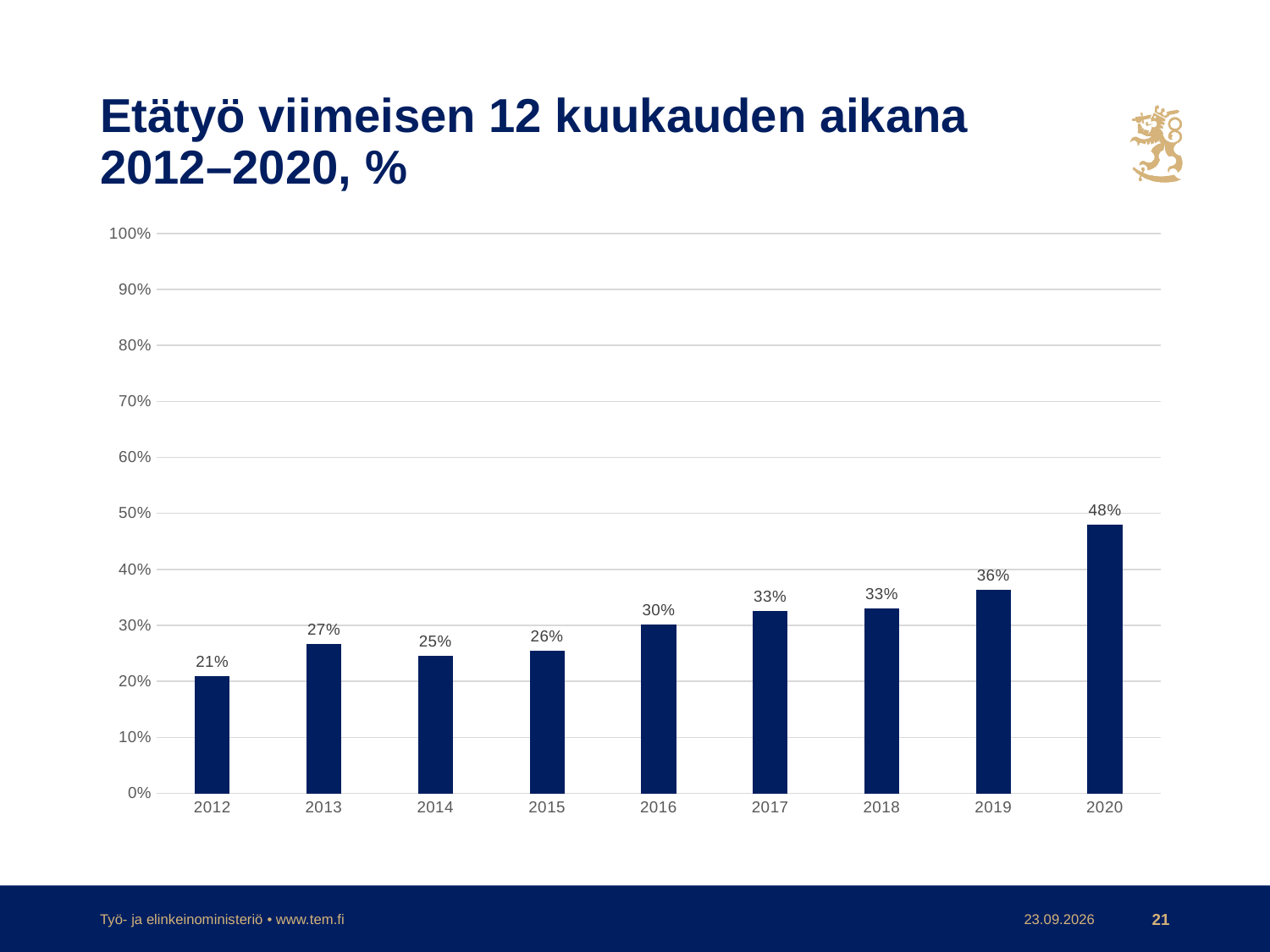
Which year has the lowest value? 2012 Is the value for 2019 greater or less than 40%? less Which is larger, the value for 2014 or the value for 2016? 2016 Do the values generally rise or fall from 2012 to 2020? rise What is the value for 2012? 21% What kind of chart is shown on the slide? bar chart What is the value for 2016? 30% What is the difference between the values for 2020 and 2019? 12% What is the difference between the values for 2013 and 2012? 6% What is the value for 2020? 48% How many years are shown on the x axis? 9 Which year has the highest value? 2020